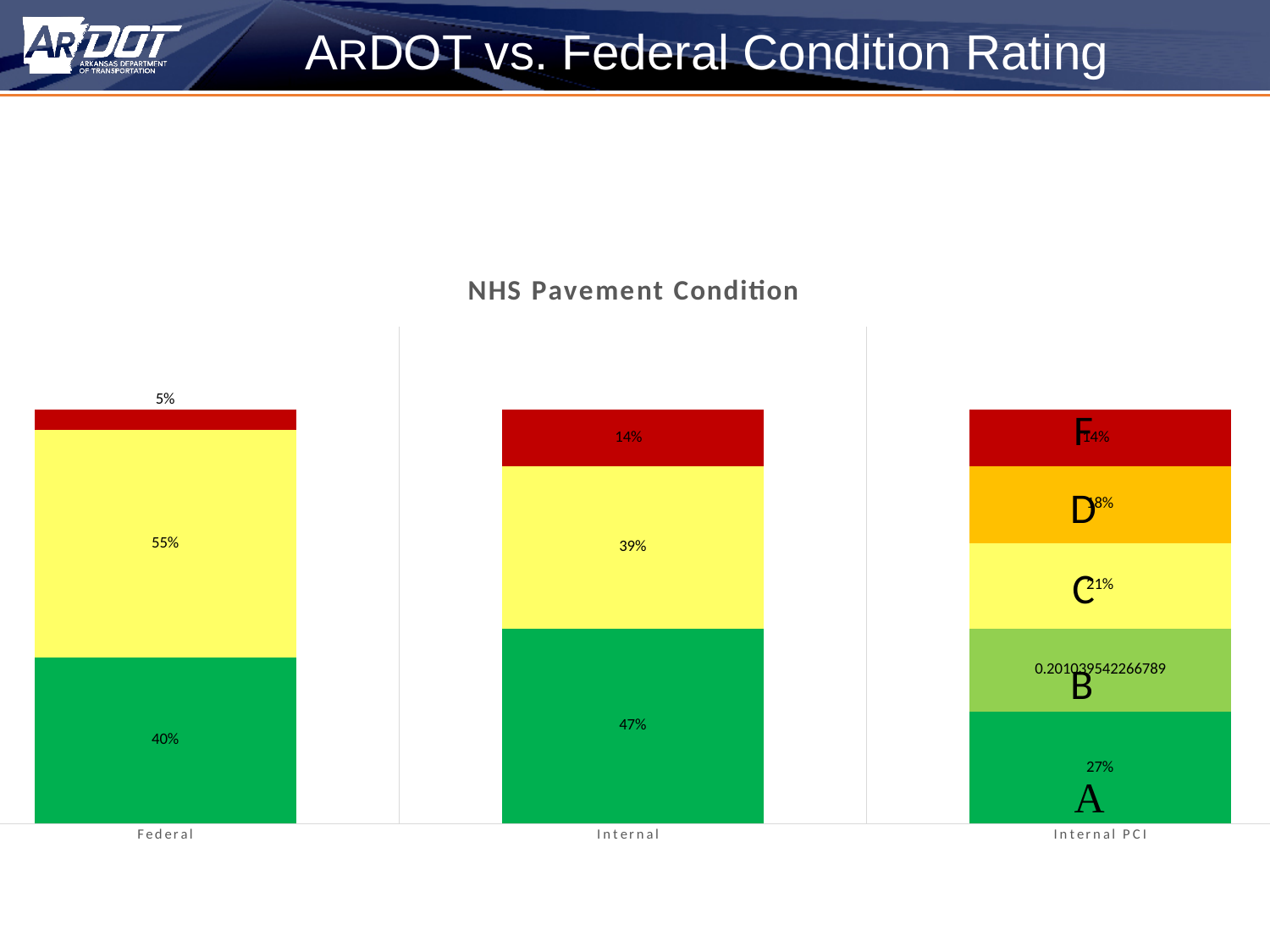
What kind of chart is shown on the slide? stacked bar chart What is the value of the red segment for the Federal bar? 5% Which is larger, the green segment of the Federal bar or the green segment of the Internal bar? Internal What is the difference between the yellow segment of the Federal bar and the yellow segment of the Internal bar? 16% What is the value of the yellow segment for the Internal bar? 39% What is the title of the chart? NHS Pavement Condition What is the value of the yellow segment for the Federal bar? 55% How many categories are shown along the x axis of the chart? 3 What is the value of the green segment for the Federal bar? 40% What is the value of the green segment labelled A in the Internal PCI bar? 27% What is the value of the green segment for the Internal bar? 47% What is the value of the red segment for the Internal bar? 14%